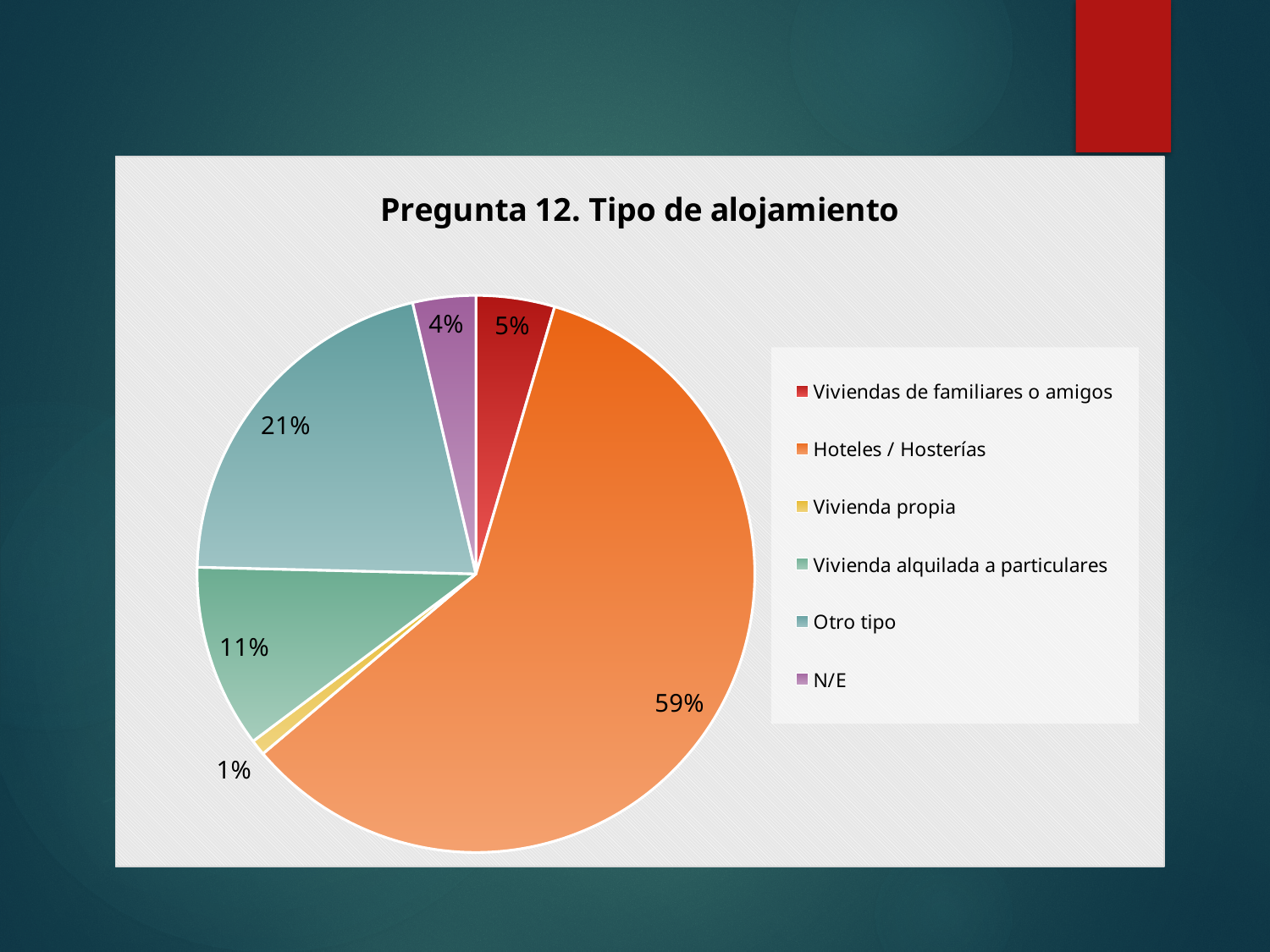
What percentage of the pie is Viviendas de familiares o amigos? 5% What percentage of the pie is Otro tipo? 21% What percentage of the pie is Hoteles / Hosterías? 59% What is the title of the chart? Pregunta 12. Tipo de alojamiento What percentage of the pie is N/E? 4% Which category has the smallest share of the pie? Vivienda propia What percentage of the pie is Vivienda alquilada a particulares? 11% What percentage of the pie is Vivienda propia? 1% How many categories does the legend list? 6 What is the difference in percentage points between Hoteles / Hosterías and Otro tipo? 38 What type of chart is shown on the slide? Pie chart Which category has the largest share of the pie? Hoteles / Hosterías